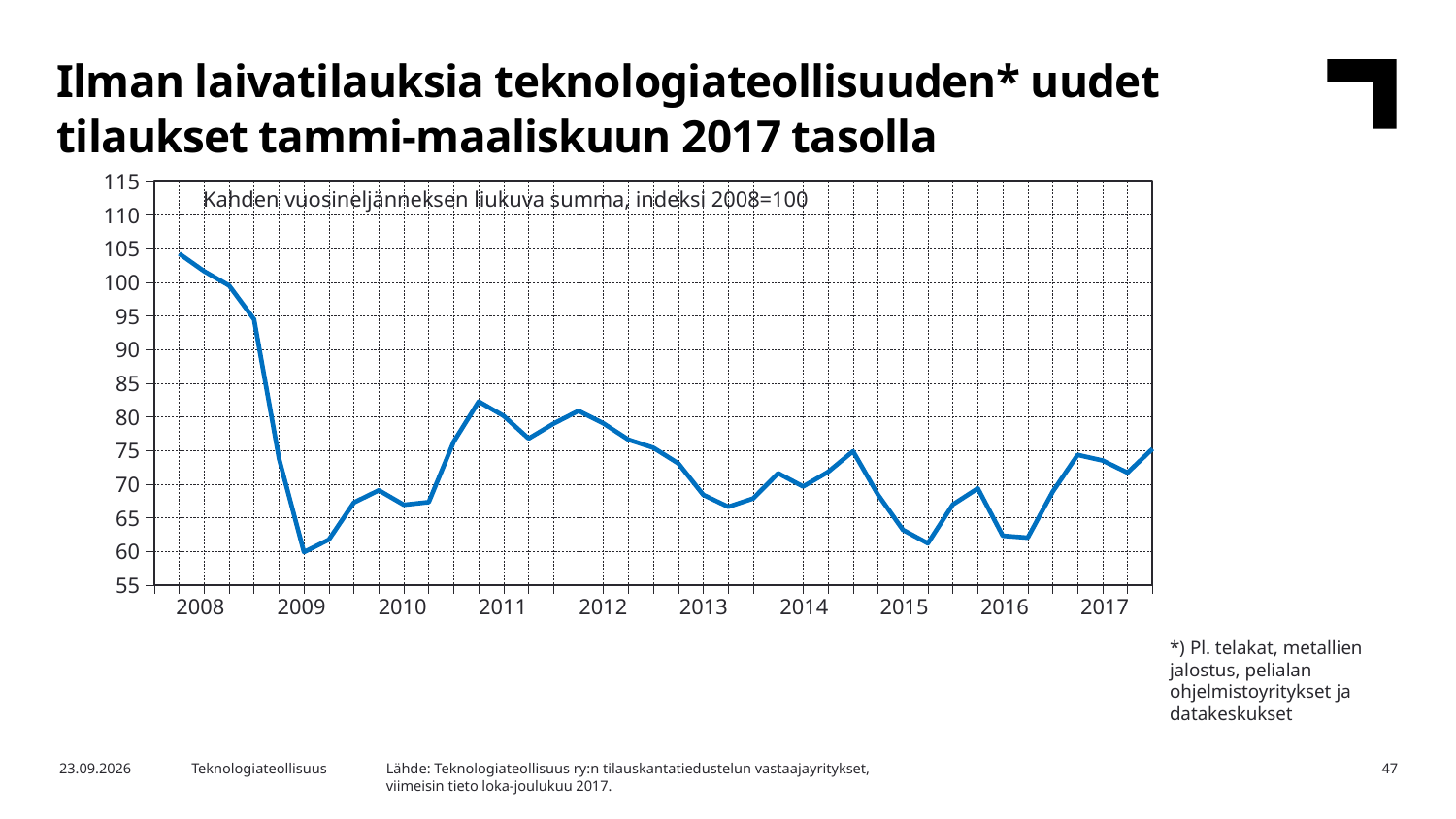
What is the lowest value shown on the y axis of the chart? 55 In which year does the line reach its highest value? 2008 Is the lowest point of the line in 2015 greater or less than 65? less How many years are labelled on the x axis of the chart? 10 Is the last value of the line, at the end of 2017, greater or less than 70? greater What subtitle is printed inside the chart area? Kahden vuosineljänneksen liukuva summa, indeksi 2008=100 Is the lowest point of the line in 2009 greater or less than 65? less Does the line rise or fall between the start of 2008 and the start of 2009? fall What kind of chart is shown on the slide? line chart Which is larger: the value at the start of 2008 or the value at the end of 2017? start of 2008